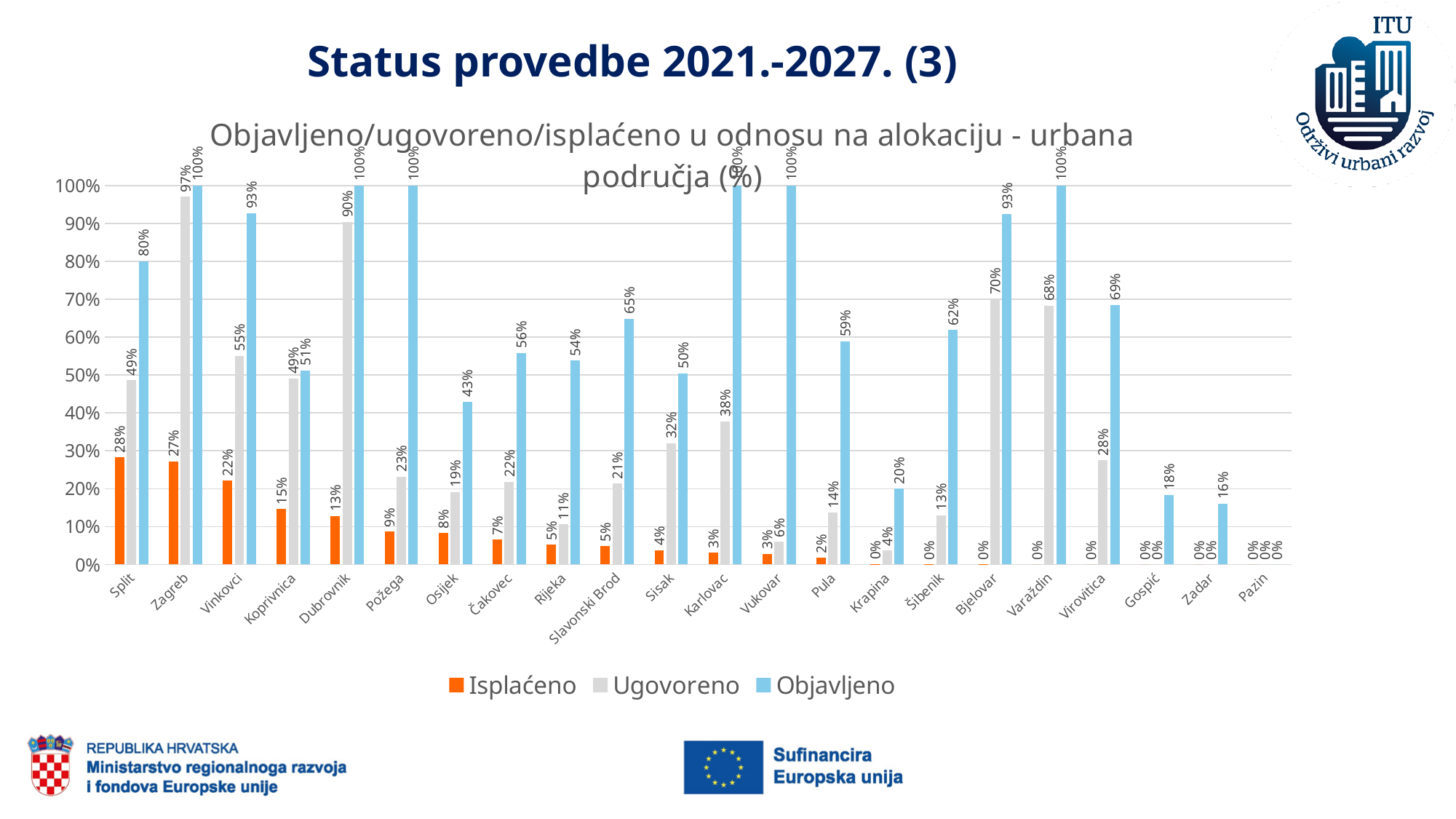
What kind of chart is shown on the slide? Bar chart What is the Isplaćeno value for Split? 28% Which city has the lowest Objavljeno value? Pazin What is the Ugovoreno value for Dubrovnik? 90% Do the Isplaćeno values generally rise or fall from left to right along the x axis? Fall What is the Objavljeno value for Slavonski Brod? 65% How many cities are shown on the x axis? 22 Which city has the highest Isplaćeno value? Split What is the difference between the Objavljeno and Ugovoreno values for Zagreb? 3% Which colour represents the Objavljeno series in the legend? Light blue Which is larger for Koprivnica: the Ugovoreno value or the Objavljeno value? Objavljeno How many series does the legend list? 3